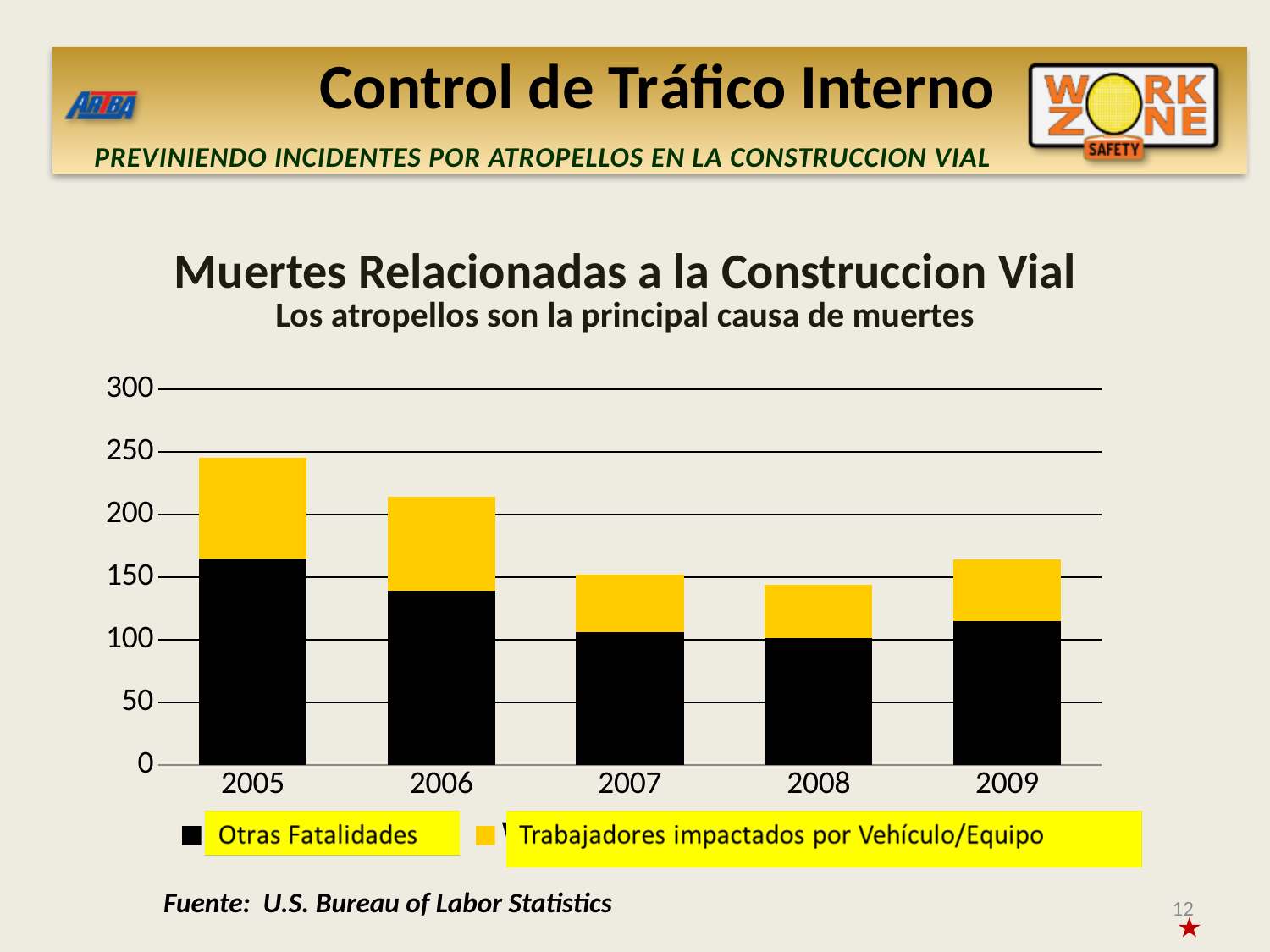
Is the 'Otras Fatalidades' value for 2008 greater or less than 150? less Which colour represents 'Trabajadores impactados por Vehículo/Equipo' in the chart? Yellow Which year has the lowest total bar in the chart? 2008 Which year has the highest total bar in the chart? 2005 Is the 'Otras Fatalidades' value for 2005 greater or less than 150? greater Is the total bar for 2005 greater or less than 200? greater What kind of chart is shown on the slide? Stacked bar chart Which year has a larger total bar, 2005 or 2006? 2005 Do the total bars rise or fall from 2005 to 2008? fall How many years are shown on the x axis of the chart? 5 How many series does the chart legend list? 2